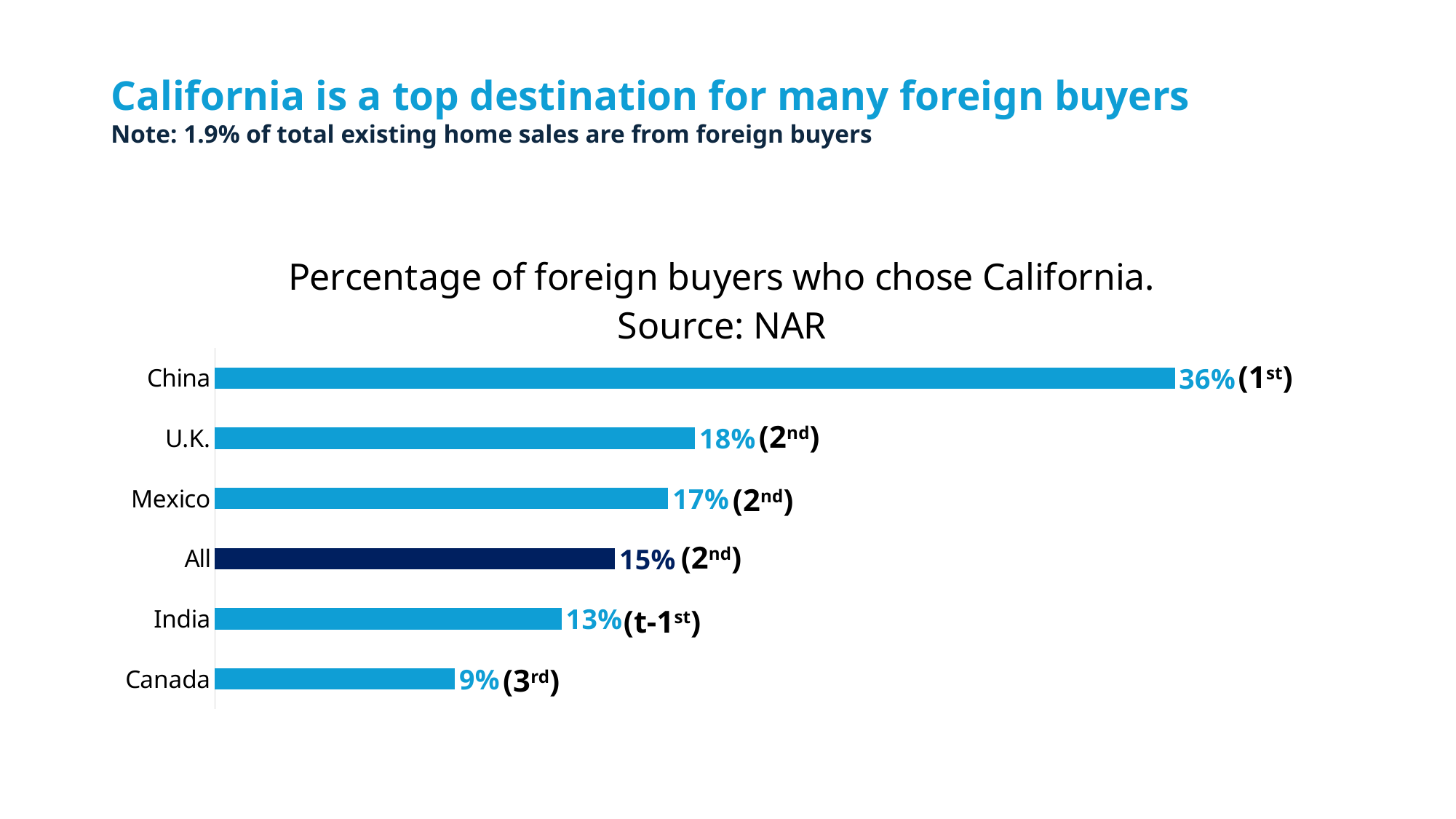
What percentage of foreign buyers from China chose California? 36% What is the difference between the percentages for China and the U.K.? 18% What is the value shown for India? 13% What percentage of foreign buyers from Canada chose California? 9% Which category has the lowest percentage in the chart? Canada What is the value shown for the 'All' bar? 15% What rank is shown in parentheses next to the China bar? 1st Which country has the highest percentage of foreign buyers choosing California? China How many bars are shown in the chart? 6 Which has a larger value, the U.K. or Mexico? U.K. What type of chart is shown on the slide? Bar chart What is the difference between the percentages for Mexico and Canada? 8%